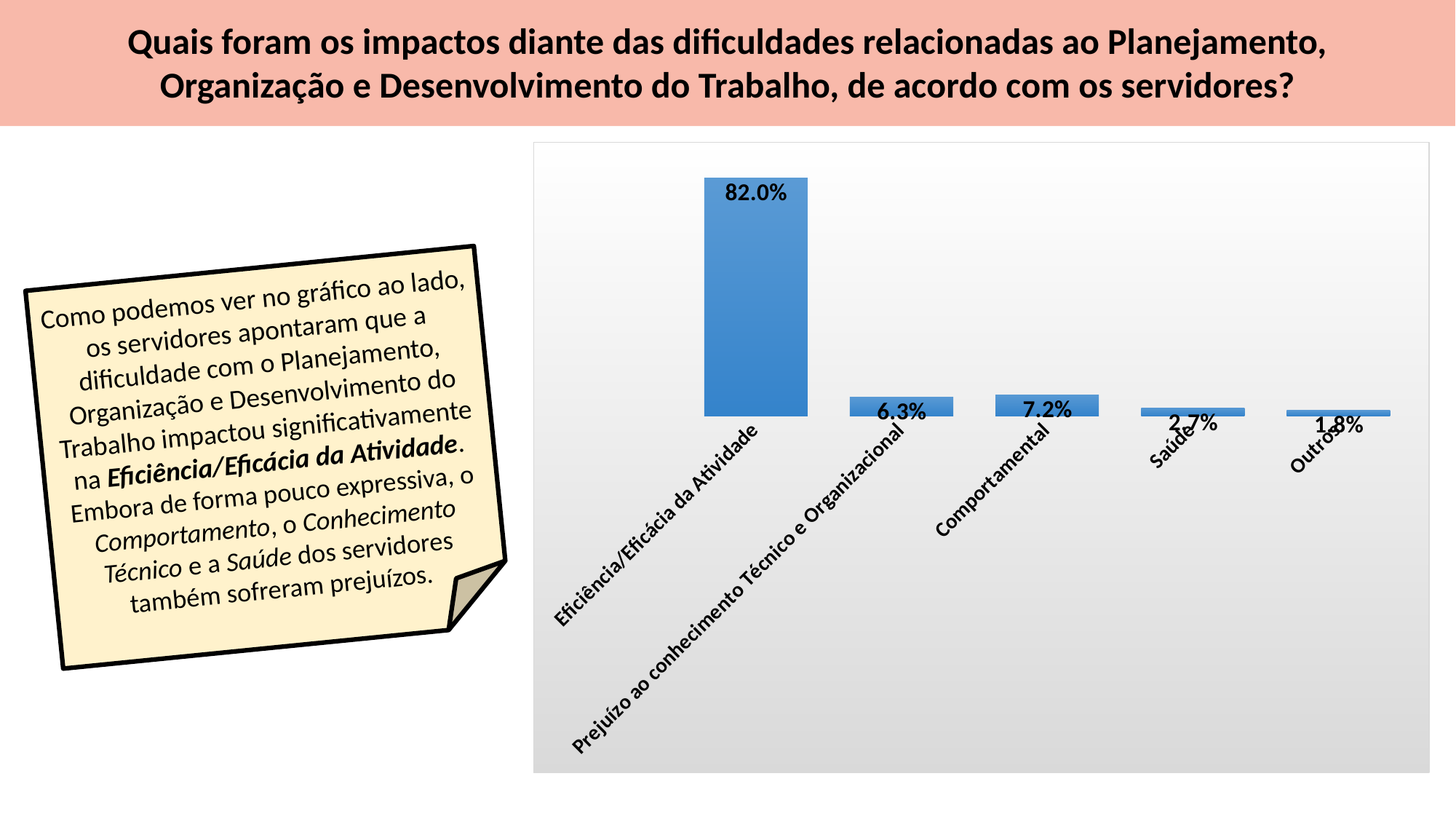
What is the value for Comportamental? 7.2% What is the value for Outros? 1.8% Which category has the lowest value? Outros What is the value for Eficiência/Eficácia da Atividade? 82.0% What is the difference between the values for Comportamental and Prejuízo ao conhecimento Técnico e Organizacional? 0.9 percentage points What is the value for Prejuízo ao conhecimento Técnico e Organizacional? 6.3% What kind of chart is shown on the slide? Bar chart Which is larger, the value for Comportamental or the value for Prejuízo ao conhecimento Técnico e Organizacional? Comportamental Which category has the highest value? Eficiência/Eficácia da Atividade What is the value for Saúde? 2.7% What is the difference between the values for Eficiência/Eficácia da Atividade and Comportamental? 74.8 percentage points How many categories are shown in the chart? 5